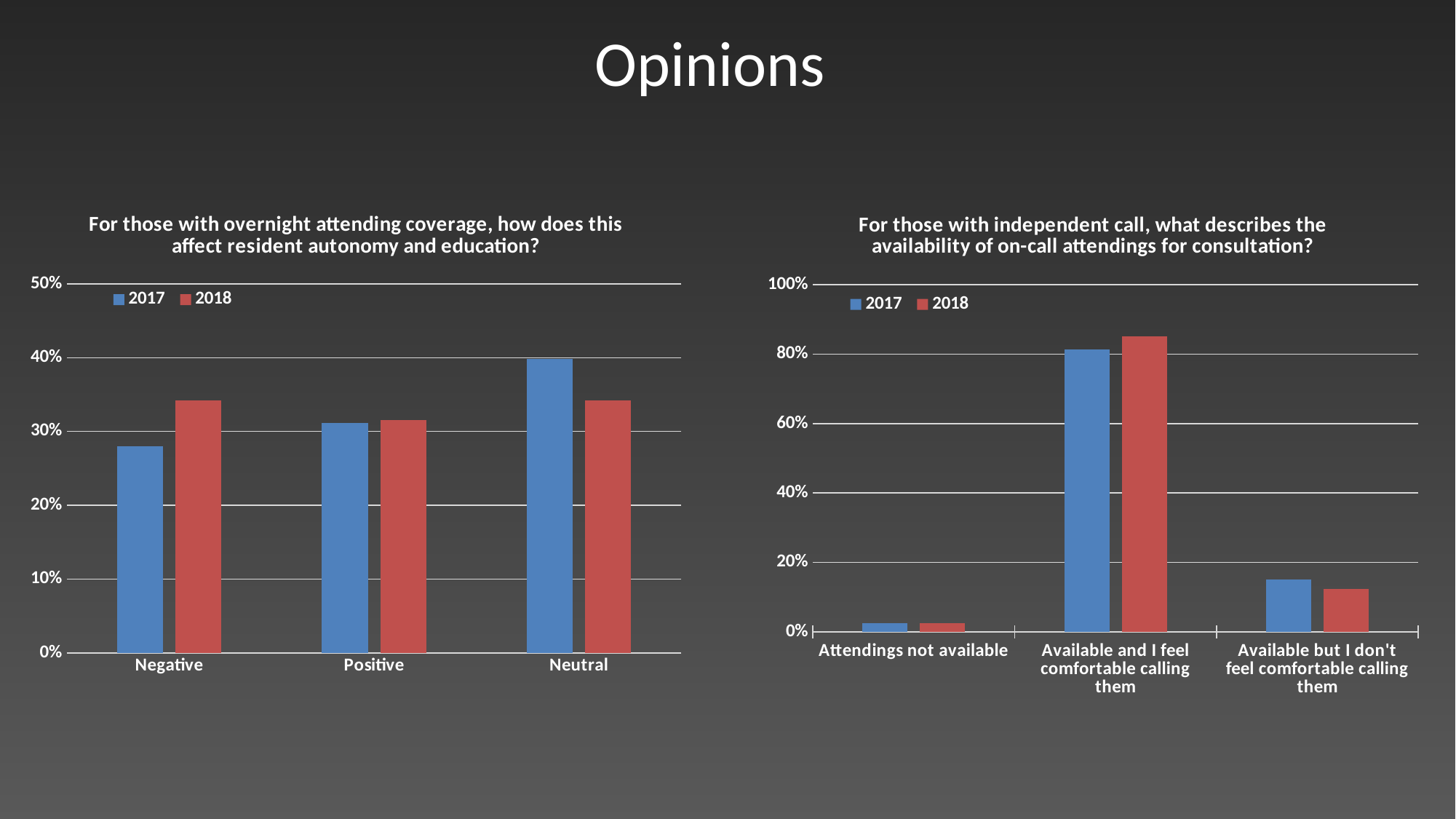
On the left chart (overnight attending coverage), for Neutral, which year has the larger value, 2017 or 2018? 2017 On the left chart (overnight attending coverage), what kind of chart is shown? bar chart On the right chart (independent call), what colour are the 2018 bars? red On the right chart (independent call), is the 2017 value for 'Available but I don't feel comfortable calling them' greater or less than 20%? less On the left chart (overnight attending coverage), is the 2018 value for Negative greater or less than 30%? greater On the left chart (overnight attending coverage), how many categories are shown on the x axis? 3 On the right chart (independent call), which category has the highest value for 2018? Available and I feel comfortable calling them On the left chart (overnight attending coverage), how many series does the legend list? 2 On the left chart (overnight attending coverage), which category has the highest value for 2017? Neutral On the right chart (independent call), is the 2017 value for 'Available and I feel comfortable calling them' greater or less than 60%? greater On the right chart (independent call), which category has the lowest value for 2017? Attendings not available